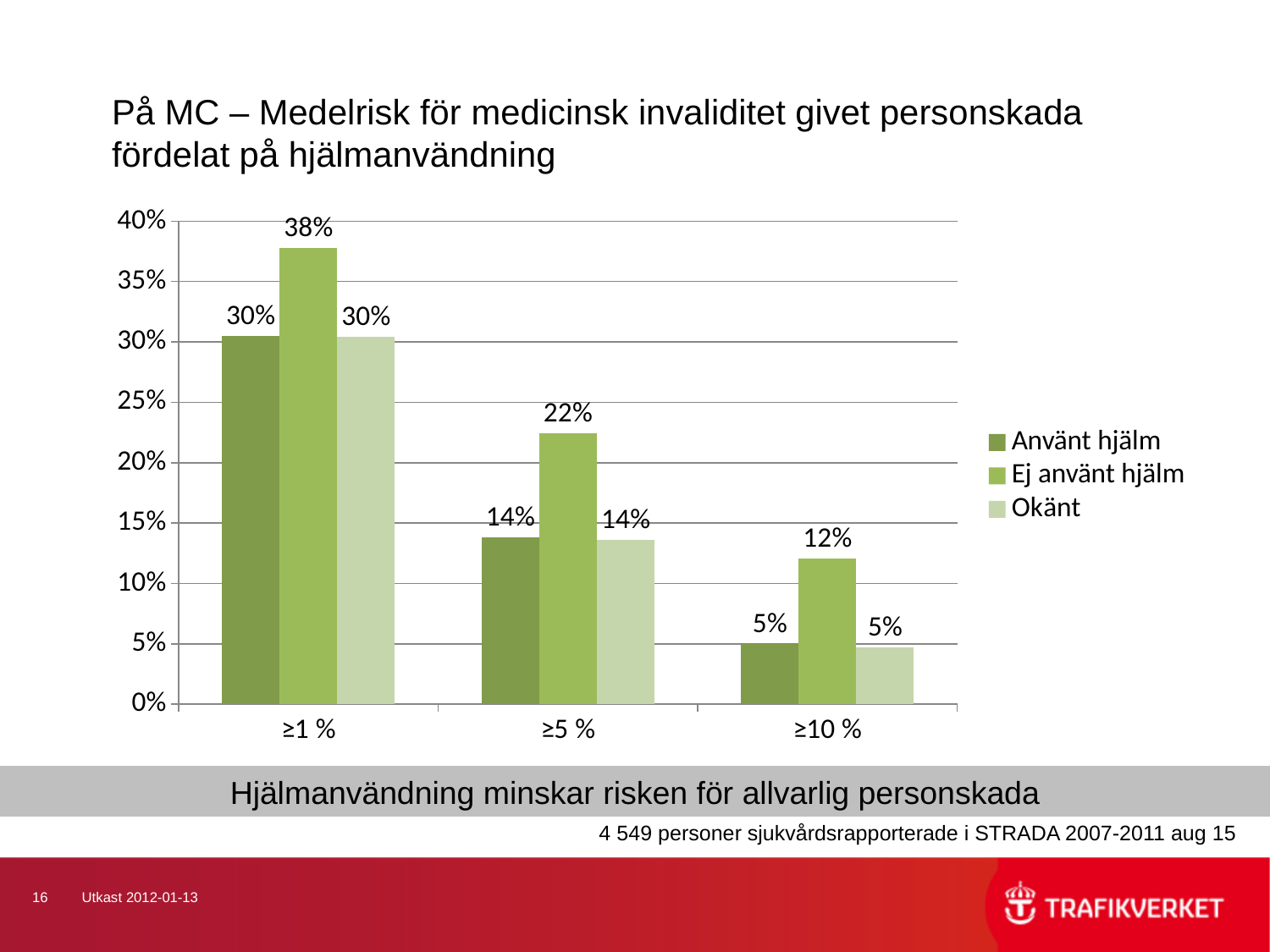
What kind of chart is shown on the slide? Bar chart What is the difference between "Ej använt hjälm" and "Använt hjälm" in the ≥1 % category? 8% What is the value for "Ej använt hjälm" in the ≥1 % category? 38% What is the difference between "Ej använt hjälm" and "Okänt" in the ≥5 % category? 8% How many series does the legend list? 3 Which is larger: "Ej använt hjälm" in the ≥5 % category or "Använt hjälm" in the ≥1 % category? Använt hjälm in the ≥1 % category Which category has the lowest value for "Ej använt hjälm"? ≥10 % What is the value for "Använt hjälm" in the ≥5 % category? 14% How many categories are shown on the x axis? 3 Do the values for "Ej använt hjälm" rise or fall from ≥1 % to ≥10 %? Fall Which series has the highest value in the ≥10 % category? Ej använt hjälm What is the value for "Okänt" in the ≥10 % category? 5%